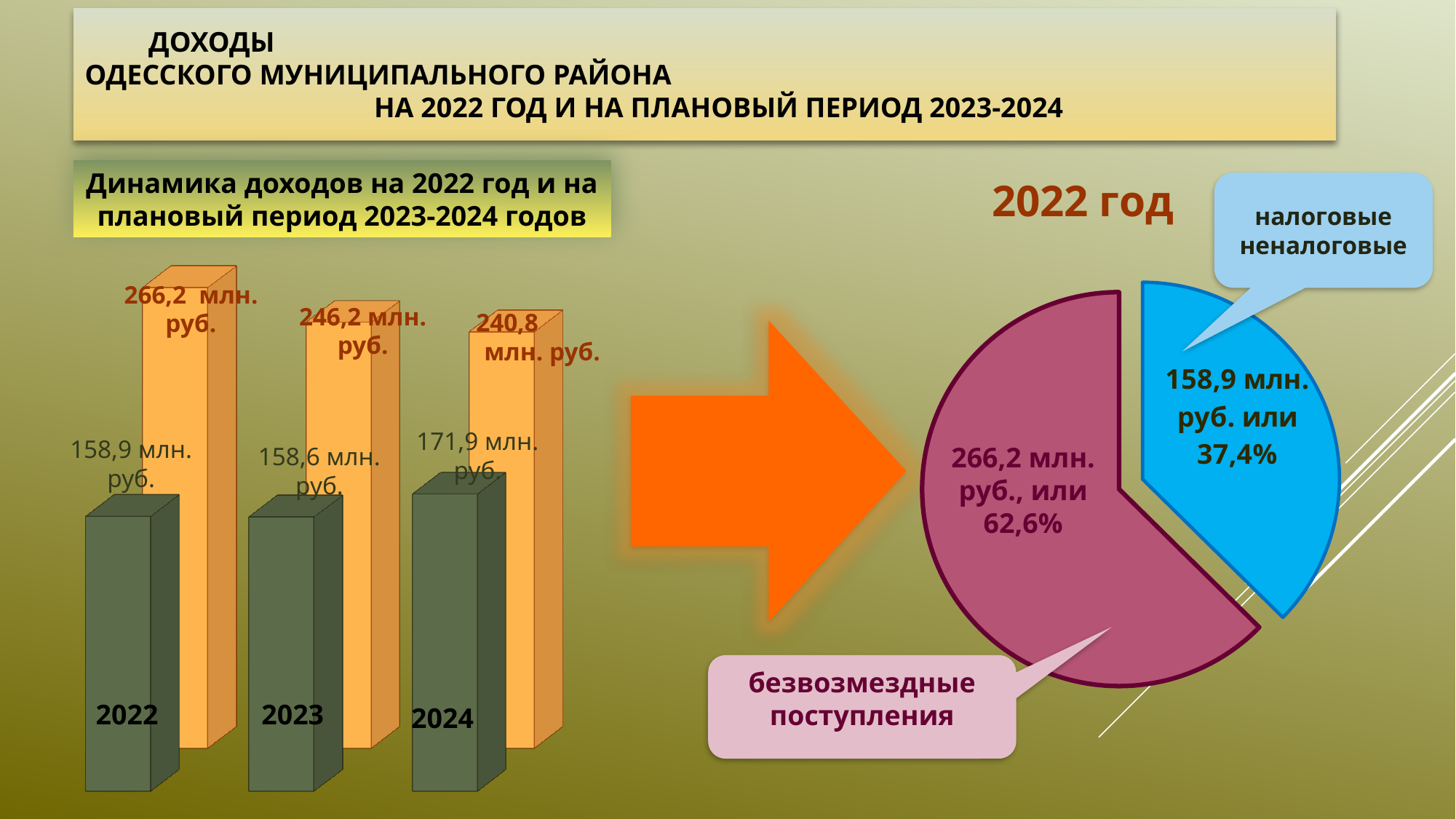
On the bar chart on the left, do the orange bar values rise or fall from 2022 to 2024? fall On the bar chart on the left, in which year is the orange bar the highest? 2022 On the bar chart on the left, how many years are shown on the x axis? 3 On the bar chart on the left, what is the difference between the orange bar values for 2022 and 2023? 20 млн. руб. On the pie chart on the right, what share of the pie is "безвозмездные поступления"? 62,6% What kind of chart is the chart titled "2022 год" on the right? pie chart On the bar chart on the left, what is the value of the dark green bar for 2023? 158,6 млн. руб. On the bar chart on the left, in which year is the orange bar the lowest? 2024 On the pie chart on the right, what is the value of the "налоговые неналоговые" slice? 158,9 млн. руб. On the bar chart on the left, what is the value of the orange bar for 2022? 266,2 млн. руб. On the bar chart on the left, what is the value of the dark green bar for 2024? 171,9 млн. руб. On the bar chart on the left, which is larger for 2024: the orange bar or the dark green bar? the orange bar (240,8 млн. руб.)